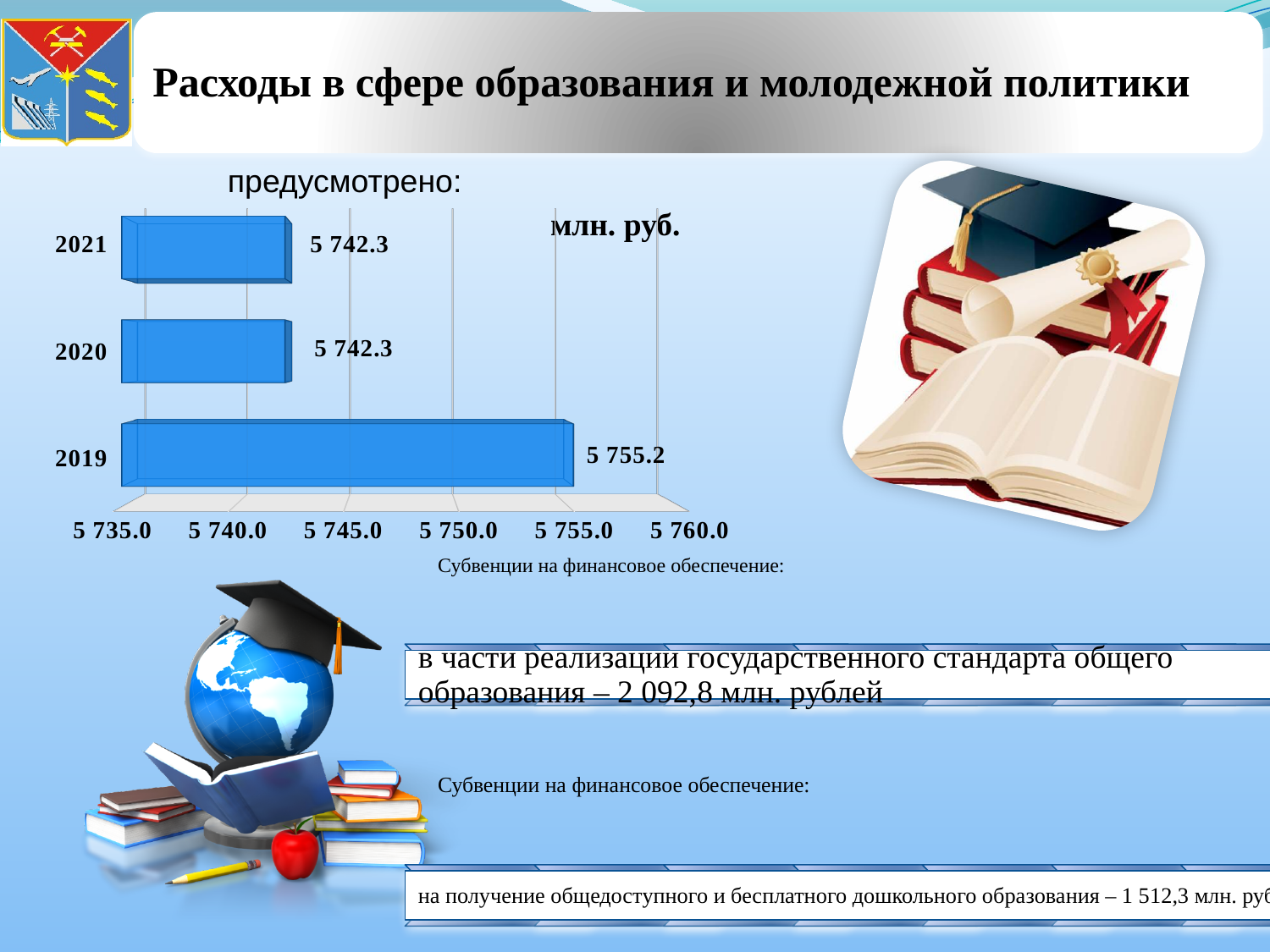
What unit is shown on the chart? млн. руб. Is the value for 2019 greater or less than 5 750.0? greater What is the difference between the values for 2019 and 2020? 12.9 What is the value for 2019? 5 755.2 What is the value for 2021? 5 742.3 How many years are shown in the chart? 3 What kind of chart is shown on the slide? bar chart What is the value for 2020? 5 742.3 Do the values rise or fall from 2019 to 2021? fall Which year has the highest value? 2019 Is the value for 2020 greater or less than 5 745.0? less Which is larger, the value for 2019 or the value for 2021? 2019